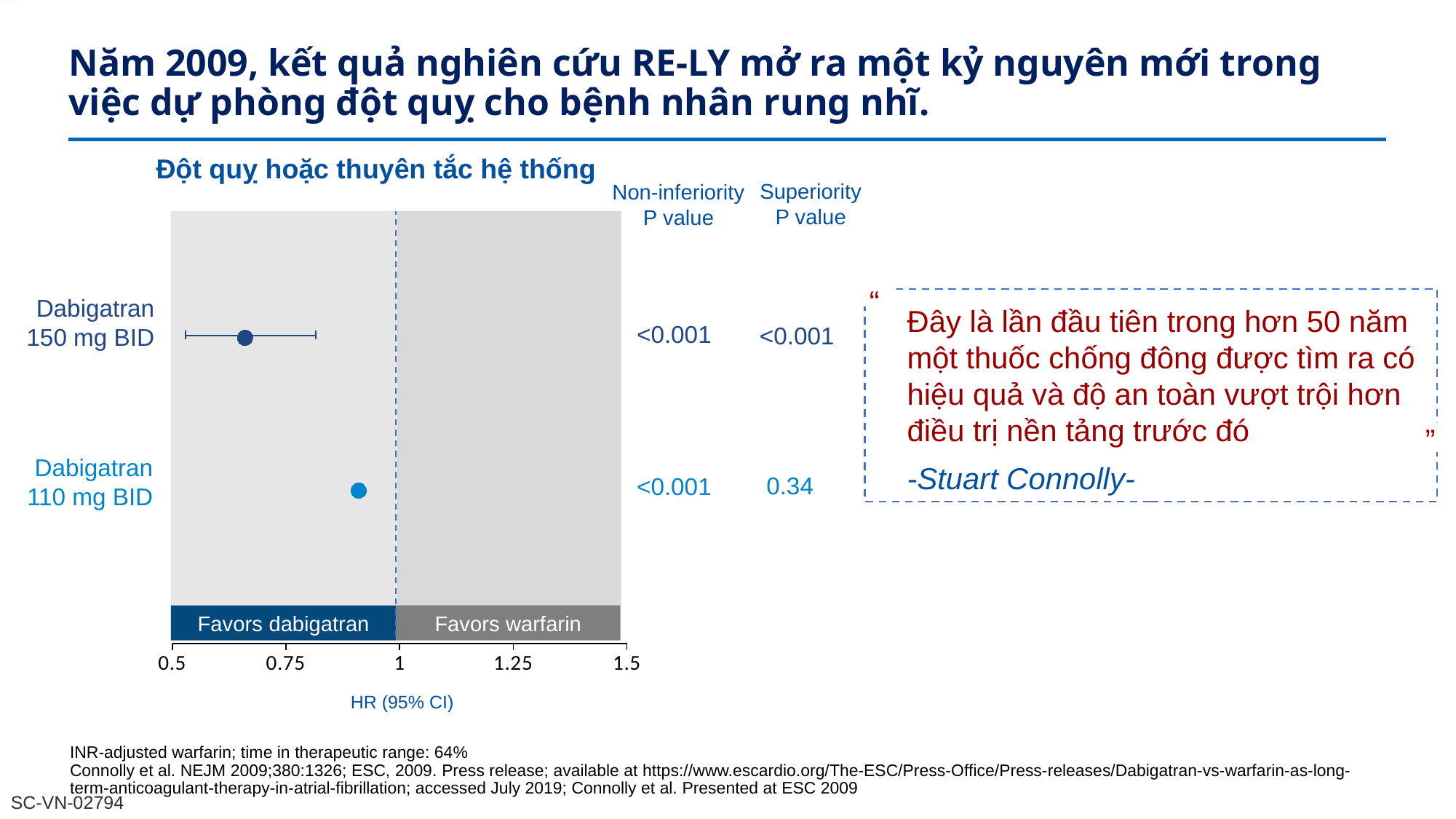
What is the superiority P value shown for Dabigatran 110 mg BID? 0.34 Which side of the vertical line at HR = 1 is labelled 'Favors warfarin'? the right side How many dabigatran dose groups are plotted in the chart? 2 Which dose group has the lower hazard ratio, Dabigatran 150 mg BID or Dabigatran 110 mg BID? Dabigatran 150 mg BID Is the hazard ratio for Dabigatran 110 mg BID greater or less than 0.75? greater Is the hazard ratio for Dabigatran 150 mg BID greater or less than 0.75? less What is the label of the x axis of the chart? HR (95% CI) Is the hazard ratio for Dabigatran 110 mg BID greater or less than 1? less What is the non-inferiority P value shown for Dabigatran 110 mg BID? <0.001 What is the superiority P value shown for Dabigatran 150 mg BID? <0.001 What is the title of the chart? Đột quỵ hoặc thuyên tắc hệ thống What is the non-inferiority P value shown for Dabigatran 150 mg BID? <0.001